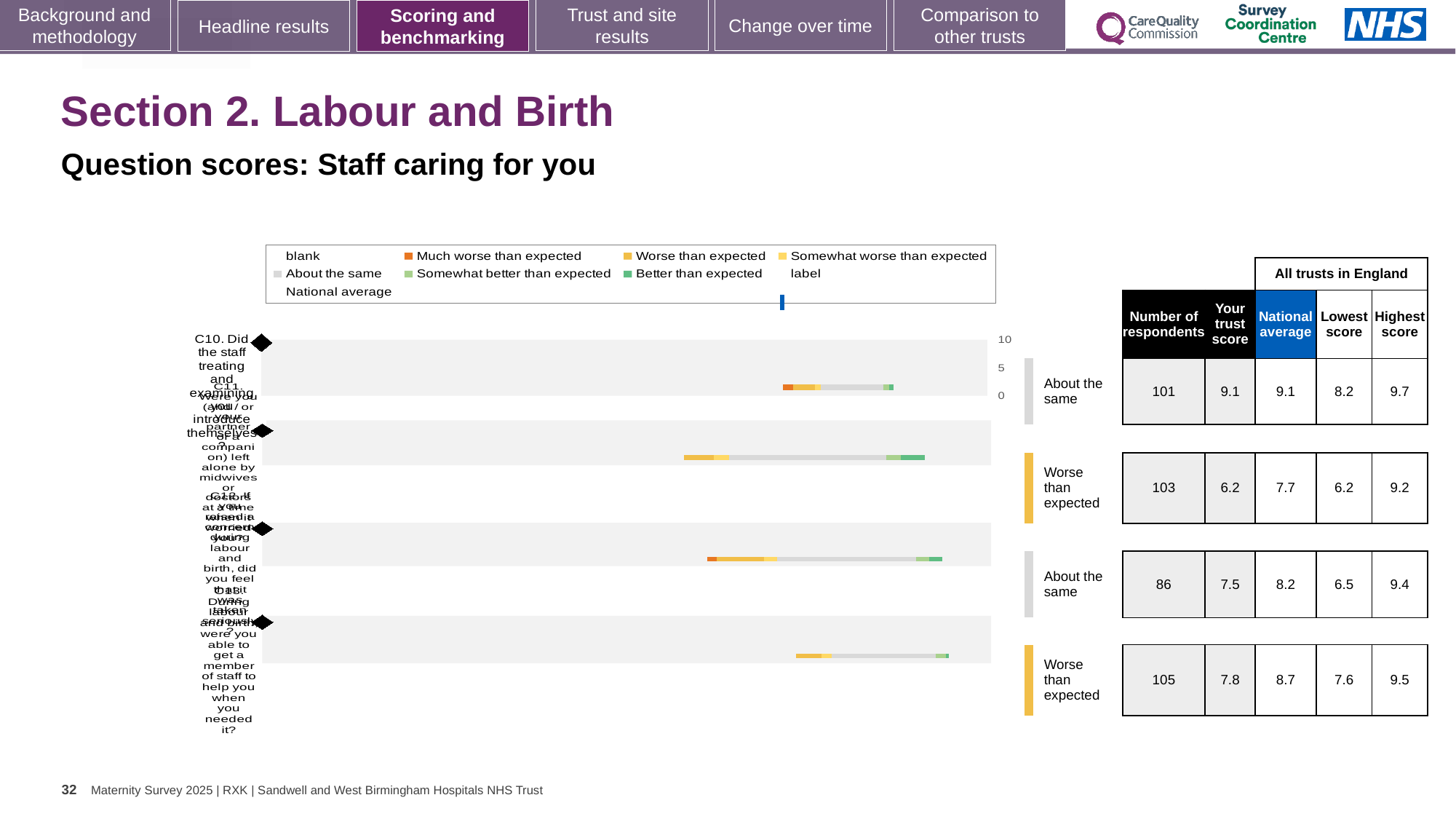
What is the 'Your trust score' for the first question, C10? 9.1 What is the national average for the third question, C12? 8.2 What kind of chart is shown on the slide? bar chart What benchmark category is shown for the second question, C11? Worse than expected Which question has the highest number of respondents? C13 What is the highest score among all trusts in England for the fourth question, C13? 9.5 Which question has the lowest 'Your trust score'? C11 How many questions (categories) are plotted in the chart? 4 What is the number of respondents for the second question, C11? 103 Is the trust score for C12 higher or lower than the national average for C12? lower What is the difference between the national average and the trust score for C11? 1.5 What colour represents 'Much worse than expected' in the legend? orange